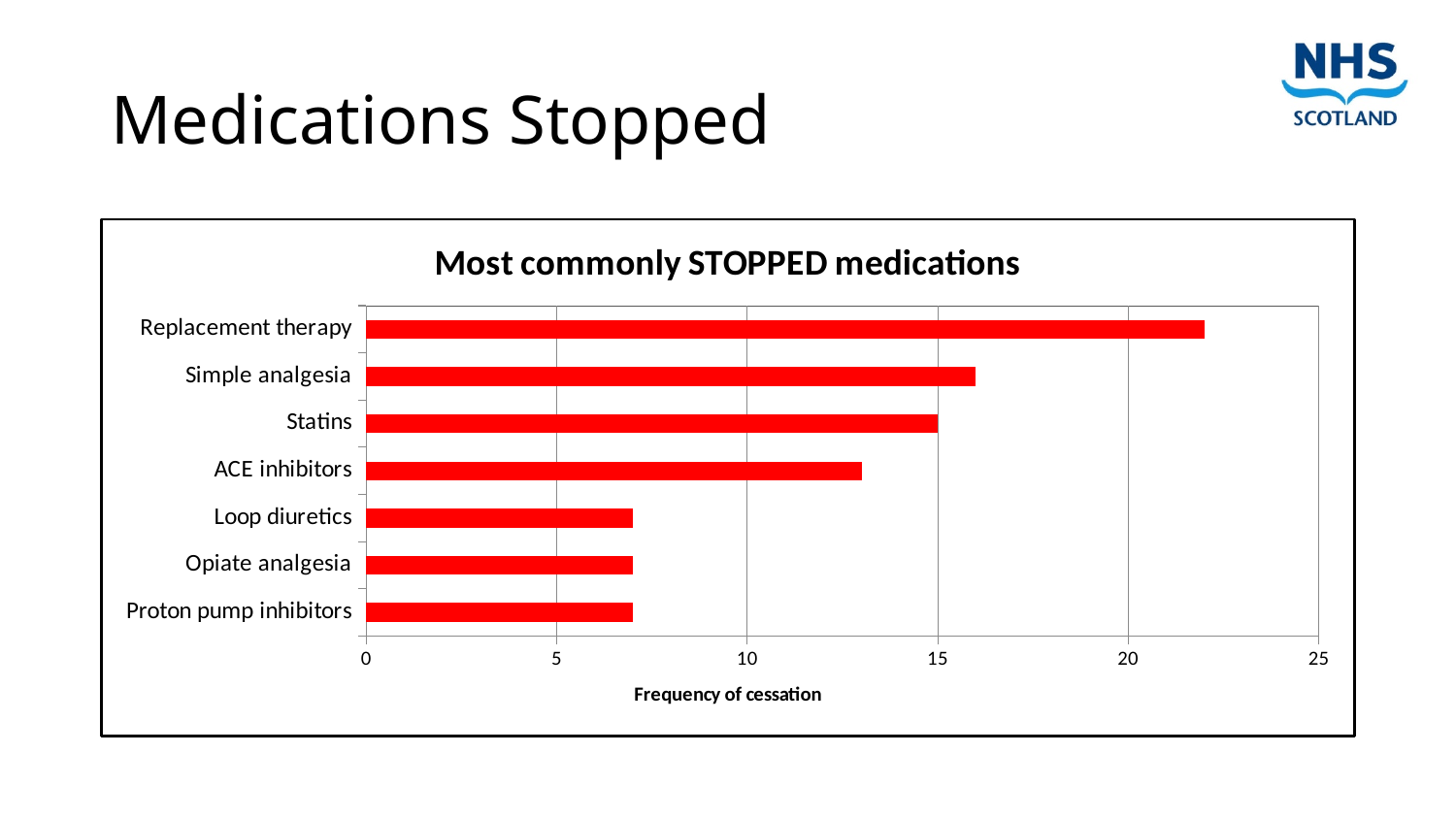
Which has a higher frequency of cessation, Replacement therapy or Simple analgesia? Replacement therapy What is the label on the horizontal axis of the chart? Frequency of cessation What is the title of the chart? Most commonly STOPPED medications Is the value for ACE inhibitors greater or less than 15? less What type of chart is shown on the slide? Bar chart Is the value for Loop diuretics greater or less than 10? less Which has a higher frequency of cessation, ACE inhibitors or Opiate analgesia? ACE inhibitors How many medication categories are shown in the chart? 7 Which medication category has the highest frequency of cessation? Replacement therapy What is the frequency of cessation for Statins? 15 Is the value for Simple analgesia greater or less than 15? greater